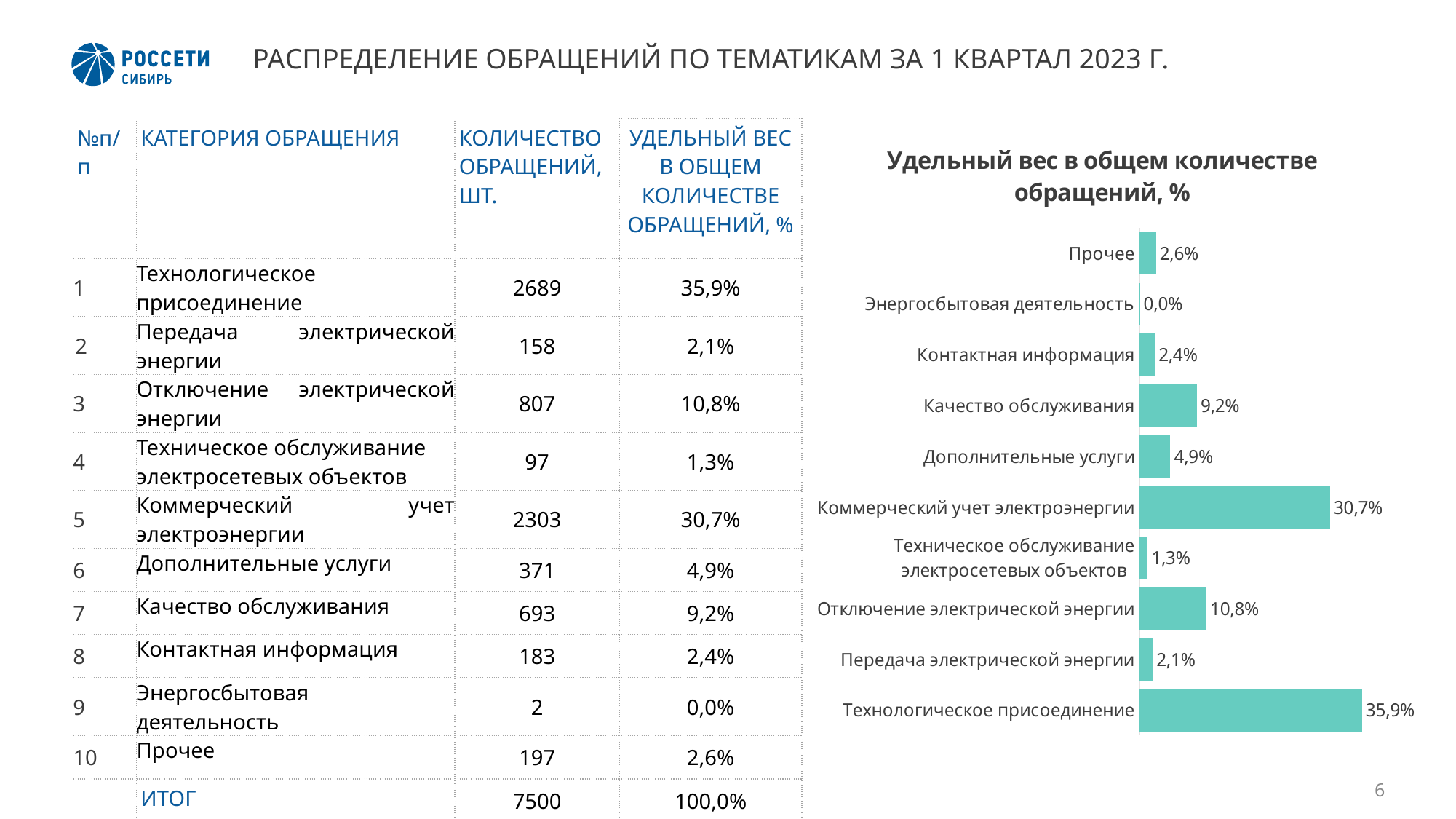
What is the title of the chart? Удельный вес в общем количестве обращений, % Which category has the highest value in the chart? Технологическое присоединение What is the value for Качество обслуживания in the chart? 9,2% What is the value for Коммерческий учет электроэнергии in the chart? 30,7% Which is larger: the value for Отключение электрической энергии or the value for Качество обслуживания? Отключение электрической энергии What is the difference between the values for Дополнительные услуги and Прочее? 2,3% Which category has the lowest value in the chart? Энергосбытовая деятельность What kind of chart is shown on the slide? bar chart What is the difference between the values for Технологическое присоединение and Коммерческий учет электроэнергии? 5,2% What is the value for Технологическое присоединение in the chart? 35,9% How many categories are shown in the chart? 10 What is the value for Энергосбытовая деятельность in the chart? 0,0%